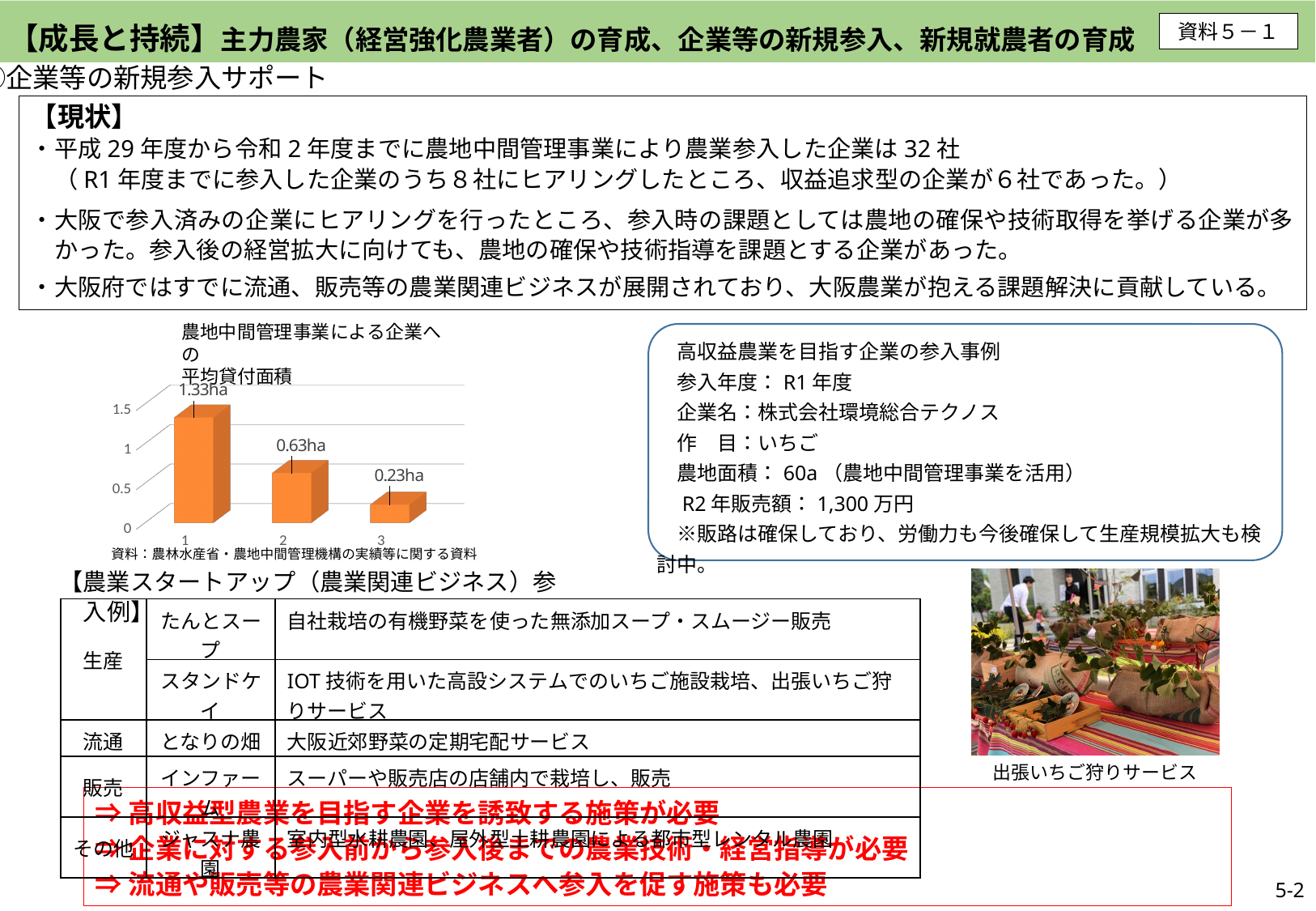
Do the values rise or fall from category 1 to category 3? fall Is the value for category 1 greater or less than 1? greater How many bars are plotted in the chart? 3 What is the value of the bar for category 2? 0.63ha Which category has the lowest value in the chart? 3 What is the title of the chart on the slide? 農地中間管理事業による企業への平均貸付面積 What is the value of the bar for category 1? 1.33ha What is the value of the bar for category 3? 0.23ha What type of chart is shown on the slide? bar chart Which is larger, the value for category 2 or the value for category 3? category 2 What is the difference between the values for category 1 and category 2? 0.70ha Which category has the highest value in the chart? 1